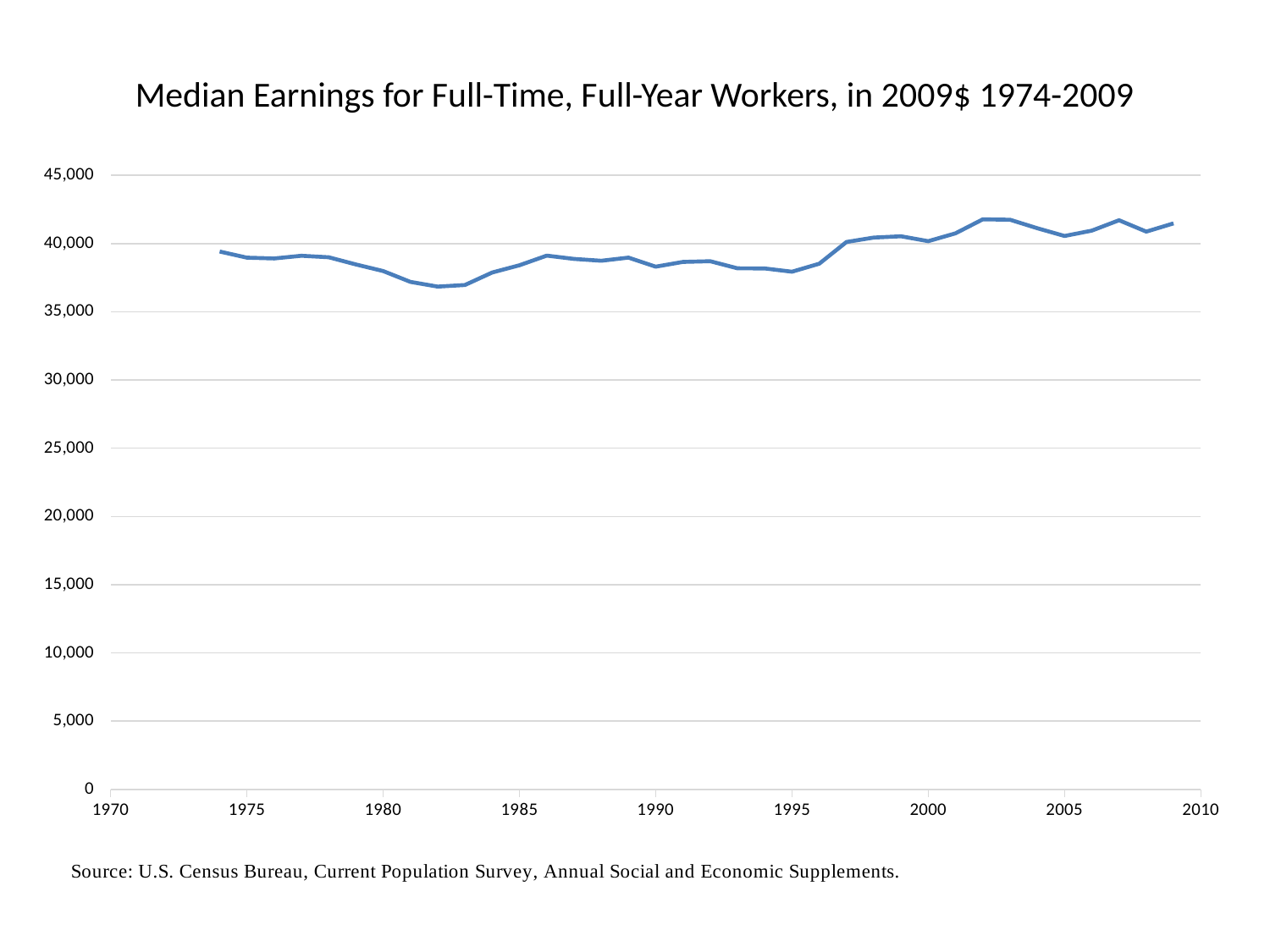
What source is cited below the chart? U.S. Census Bureau, Current Population Survey, Annual Social and Economic Supplements. Do the values rise or fall between 1995 and 2002? rise Is the value for 1990 greater or less than 40,000? less Is the value for 1982 greater or less than 40,000? less Is the value for 2007 greater or less than 40,000? greater Do the values rise or fall between 1974 and 1982? fall What is the title of the chart? Median Earnings for Full-Time, Full-Year Workers, in 2009$ 1974-2009 Around which year does the line reach its lowest point? 1982 How many lines are plotted on the chart? 1 What kind of chart is shown on the slide? line chart